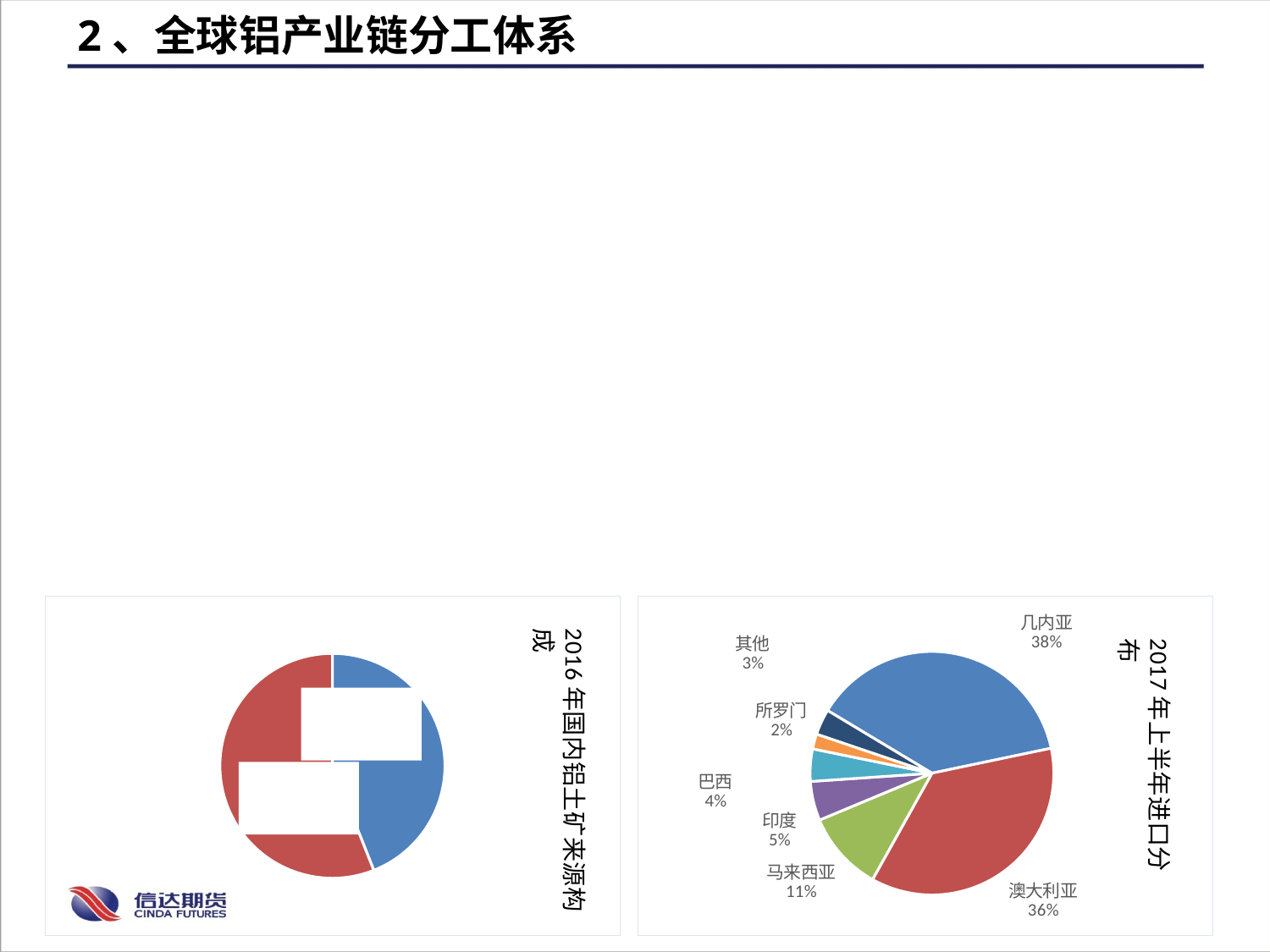
In the chart titled 2017年上半年进口分布, what share does 澳大利亚 have? 36% What kind of chart is the chart on the left of the slide, titled 2016年国内铝土矿来源构成? Pie chart In the chart titled 2017年上半年进口分布, what share does 所罗门 have? 2% In the chart titled 2017年上半年进口分布, which category has the smallest share? 所罗门 In the chart titled 2017年上半年进口分布, which category has the largest share? 几内亚 In the chart titled 2017年上半年进口分布, how many slices does the pie have? 7 In the chart titled 2017年上半年进口分布, what colour is the 澳大利亚 slice? Red What kind of chart is the chart titled 2017年上半年进口分布? Pie chart In the chart titled 2017年上半年进口分布, which has a larger share, 印度 or 巴西? 印度 In the chart titled 2017年上半年进口分布, what share does 几内亚 have? 38% In the chart titled 2017年上半年进口分布, what share does 马来西亚 have? 11% In the chart titled 2017年上半年进口分布, what is the difference in percentage points between 几内亚 and 澳大利亚? 2